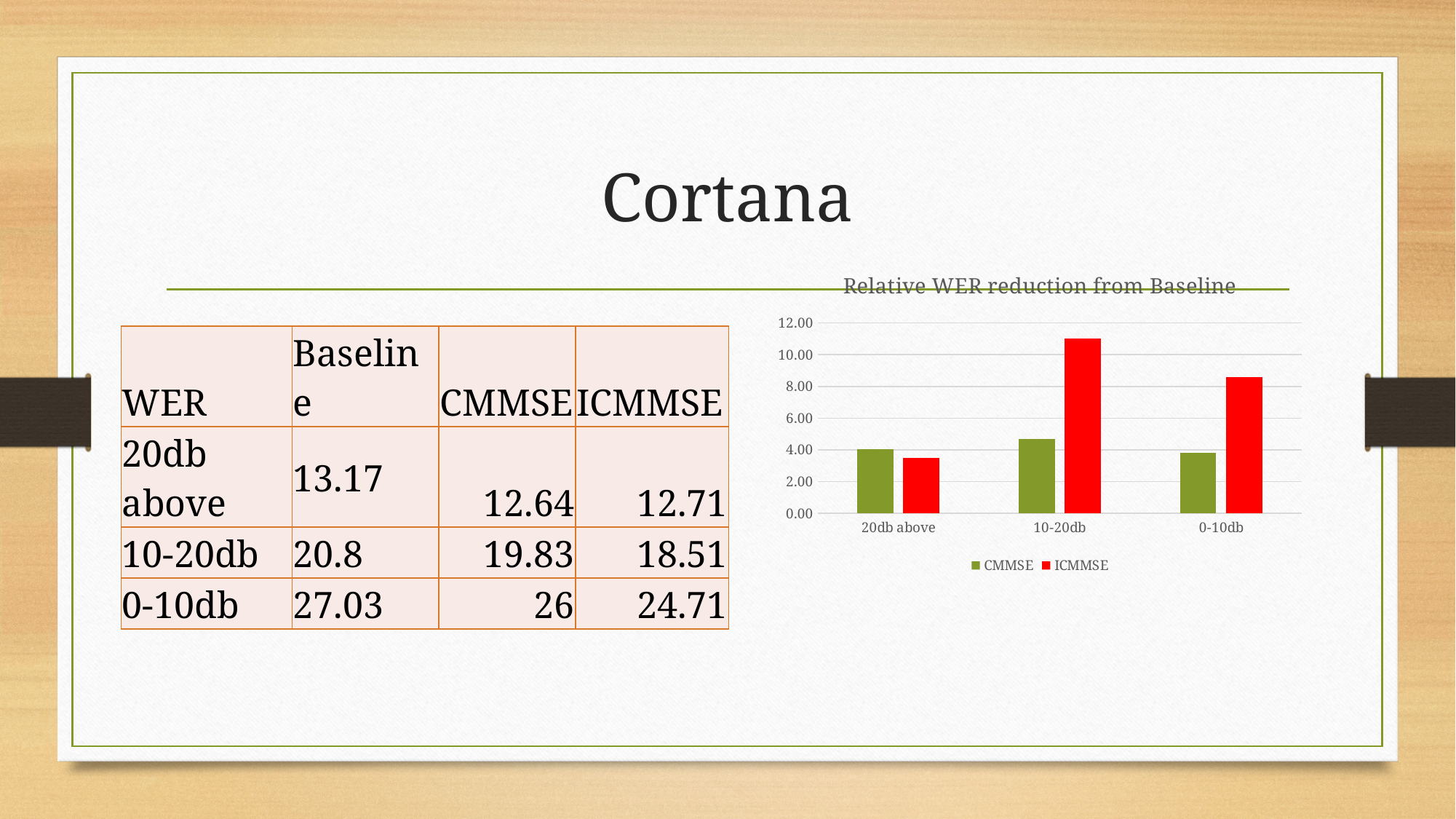
Which category has the lowest ICMMSE bar in the chart? 20db above Which category has the highest CMMSE bar in the chart? 10-20db In the chart, for 20db above, which series has the larger value, CMMSE or ICMMSE? CMMSE What is the title of the chart? Relative WER reduction from Baseline What kind of chart is shown on the slide? bar chart Is the CMMSE value for 10-20db greater or less than 6.00? less How many categories are shown on the x axis of the chart? 3 Which colour represents the ICMMSE series in the chart? red How many series does the chart legend list? 2 Is the ICMMSE value for 10-20db greater or less than 10.00? greater Which category has the highest ICMMSE bar in the chart? 10-20db In the chart, for 10-20db, which series has the larger value, CMMSE or ICMMSE? ICMMSE